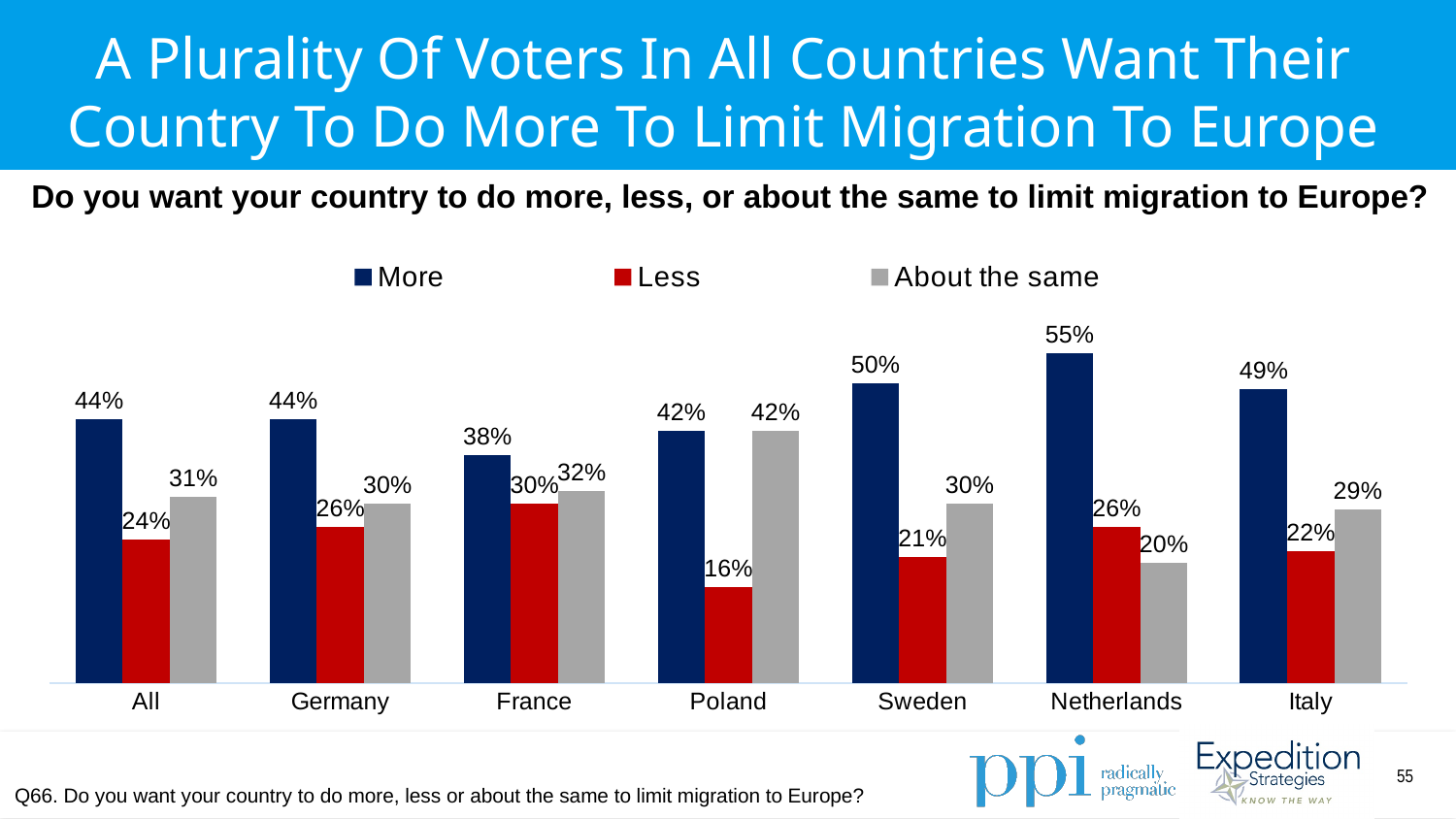
What kind of chart is shown on the slide? Bar chart What is the 'About the same' value for France? 32% What is the difference between the 'More' and 'Less' values for Sweden? 29 percentage points What colour represents the 'Less' series in the legend? Red How many countries/categories are shown on the x axis? 7 What percentage of voters in the Netherlands want their country to do more to limit migration to Europe? 55% Which country has the lowest 'Less' value? Poland How many series does the legend list? 3 Which country has the highest 'More' value? Netherlands What is the 'Less' value for Poland? 16% Which country has the lowest 'About the same' value? Netherlands Which is larger for Italy: the 'More' value or the 'About the same' value? More